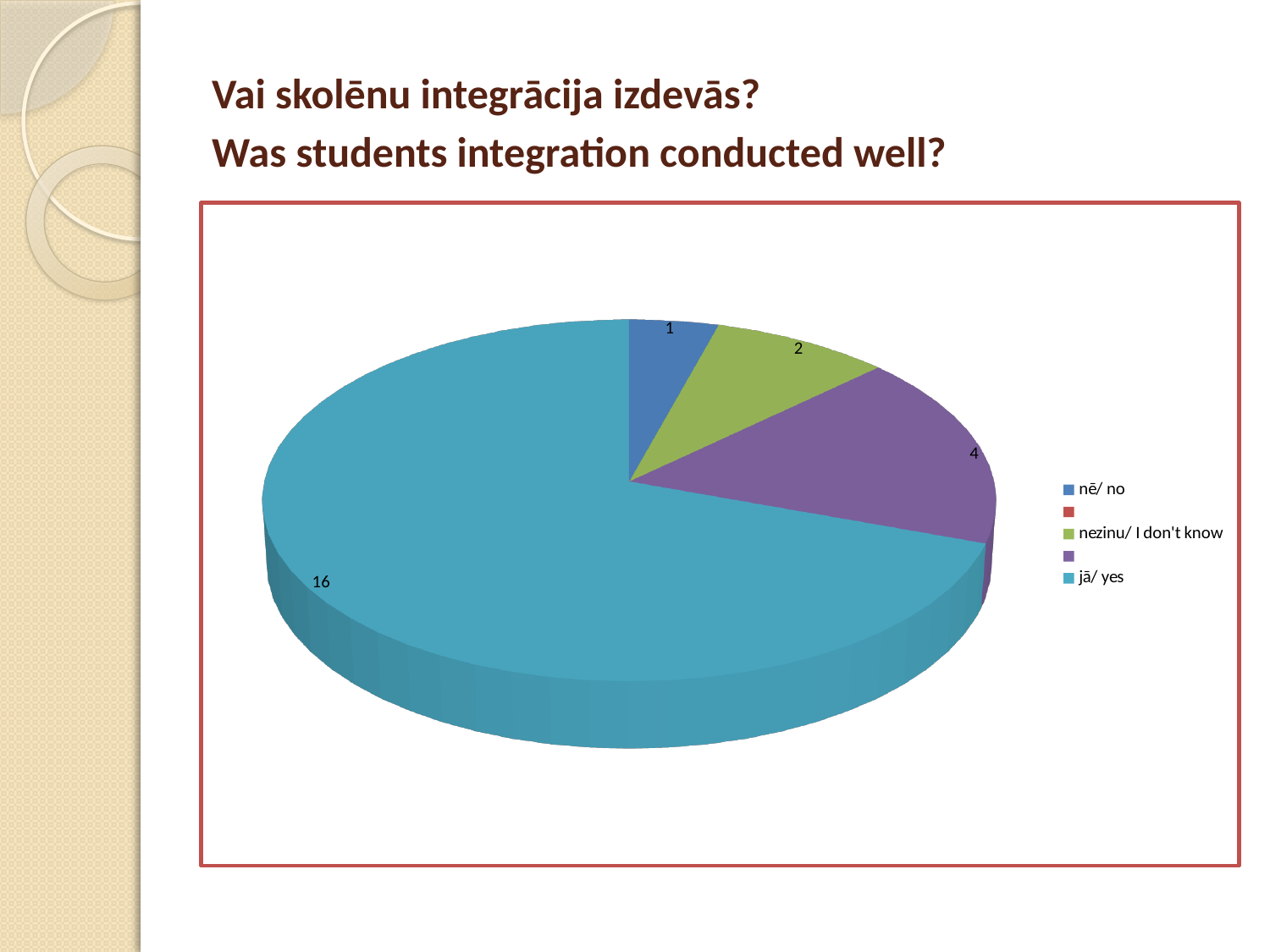
What is the difference between the "jā/ yes" value and the "nē/ no" value? 15 How many slices are visible in the pie chart? 4 What value is shown for the "nezinu/ I don't know" slice of the pie chart? 2 How many entries does the legend of the pie chart list? 5 What value is printed on the purple slice of the pie chart? 4 Which is larger, the value for "nezinu/ I don't know" or the value for "nē/ no"? nezinu/ I don't know What value is shown for the "nē/ no" slice of the pie chart? 1 Which labelled category has the smallest slice in the pie chart? nē/ no What kind of chart is shown on the slide? pie chart What value is shown for the "jā/ yes" slice of the pie chart? 16 Which category has the largest slice in the pie chart? jā/ yes What is the difference between the "jā/ yes" value and the "nezinu/ I don't know" value? 14